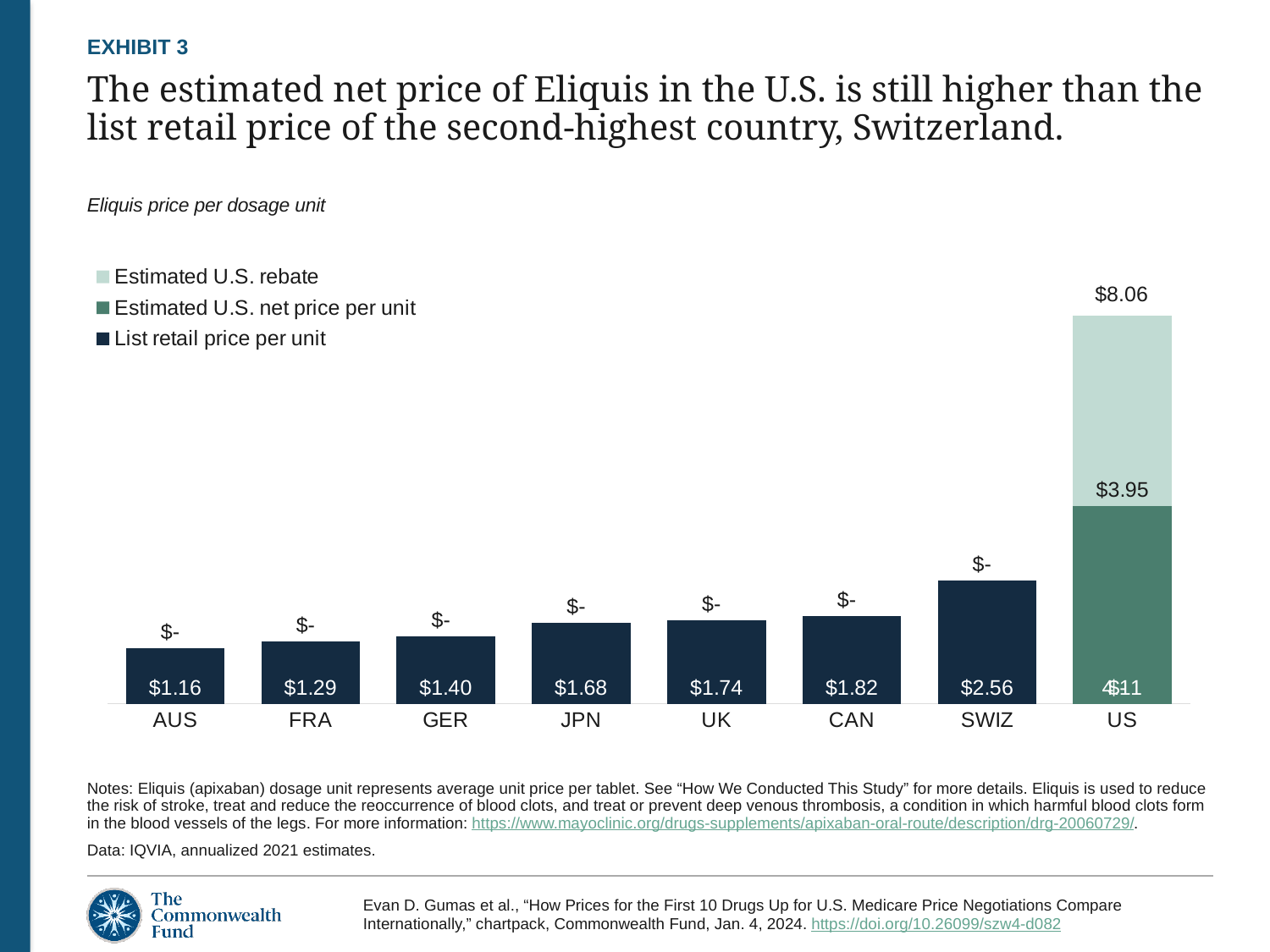
Which country has the lowest list retail price per unit? AUS Which has the higher list retail price per unit, JPN or UK? UK Do the list retail prices per unit rise or fall from AUS to SWIZ along the x axis? Rise How many series does the legend list? 3 What is the list retail price per unit for AUS? $1.16 How many countries are shown on the x axis? 8 What is the estimated U.S. net price per unit shown for the US bar? $4.11 What type of chart is shown on the slide? Stacked bar chart What is the estimated U.S. rebate value shown for the US bar? $3.95 What is the difference between the list retail price per unit for SWIZ and CAN? $0.74 Which country has the tallest bar in the chart? US What is the list retail price per unit for SWIZ? $2.56